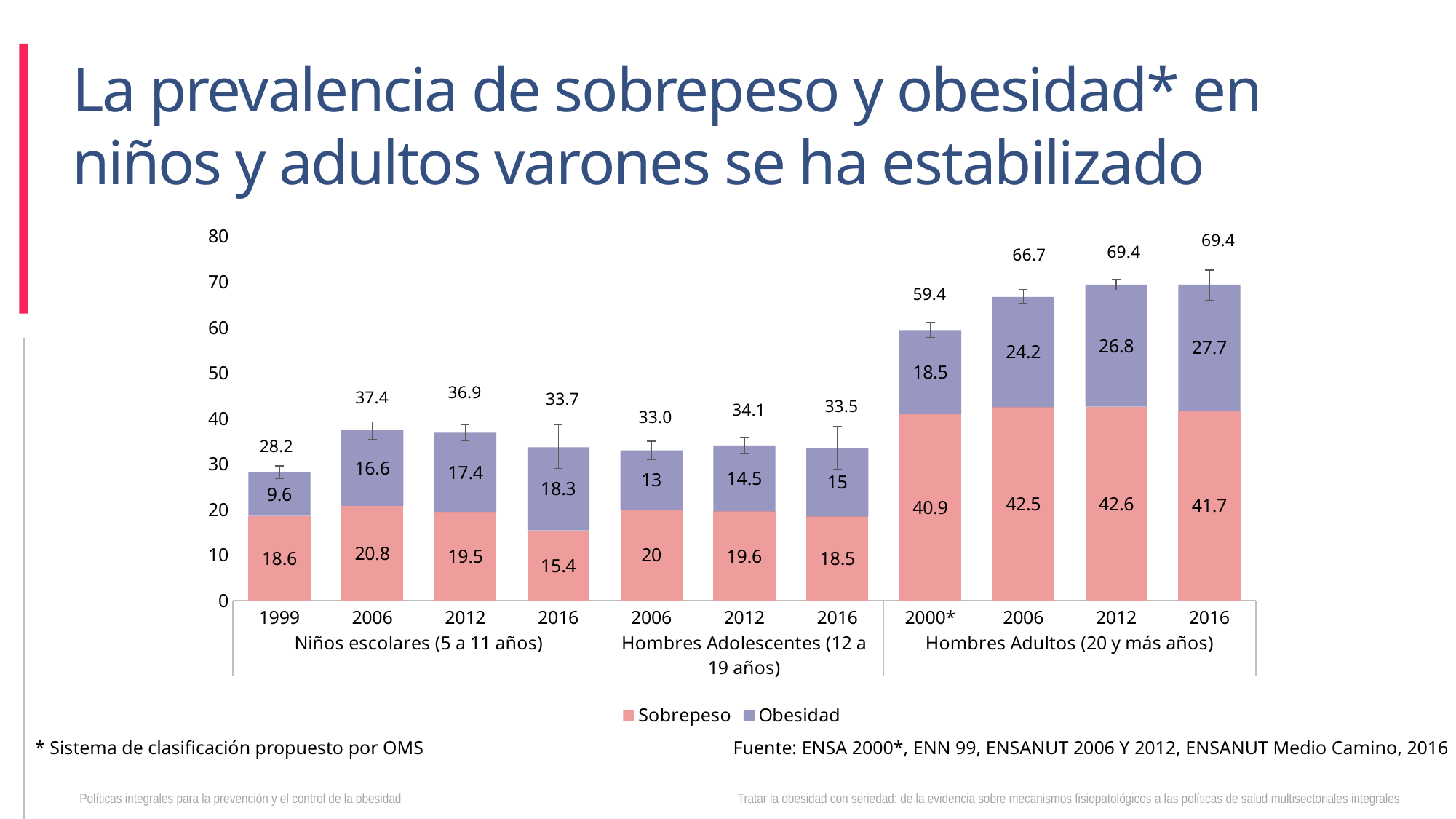
Which is larger: the Sobrepeso value for Niños escolares in 1999 or in 2016? 1999 Does the Obesidad value for Niños escolares rise or fall from 1999 to 2016? Rise How many bars are plotted in the chart? 11 What is the total shown above the bar for Hombres Adolescentes in 2012? 34.1 Which bar has the lowest total value in the chart? Niños escolares 1999 What is the Sobrepeso value for Niños escolares in 2006? 20.8 What type of chart is shown on the slide? Stacked bar chart What is the difference between the Obesidad values for Hombres Adultos in 2016 and 2000*? 9.2 How many series does the legend list? 2 Which colour represents Sobrepeso in the chart? Pink Is the total for Hombres Adultos in 2006 greater or less than 60? greater What is the Obesidad value for Hombres Adultos in 2016? 27.7